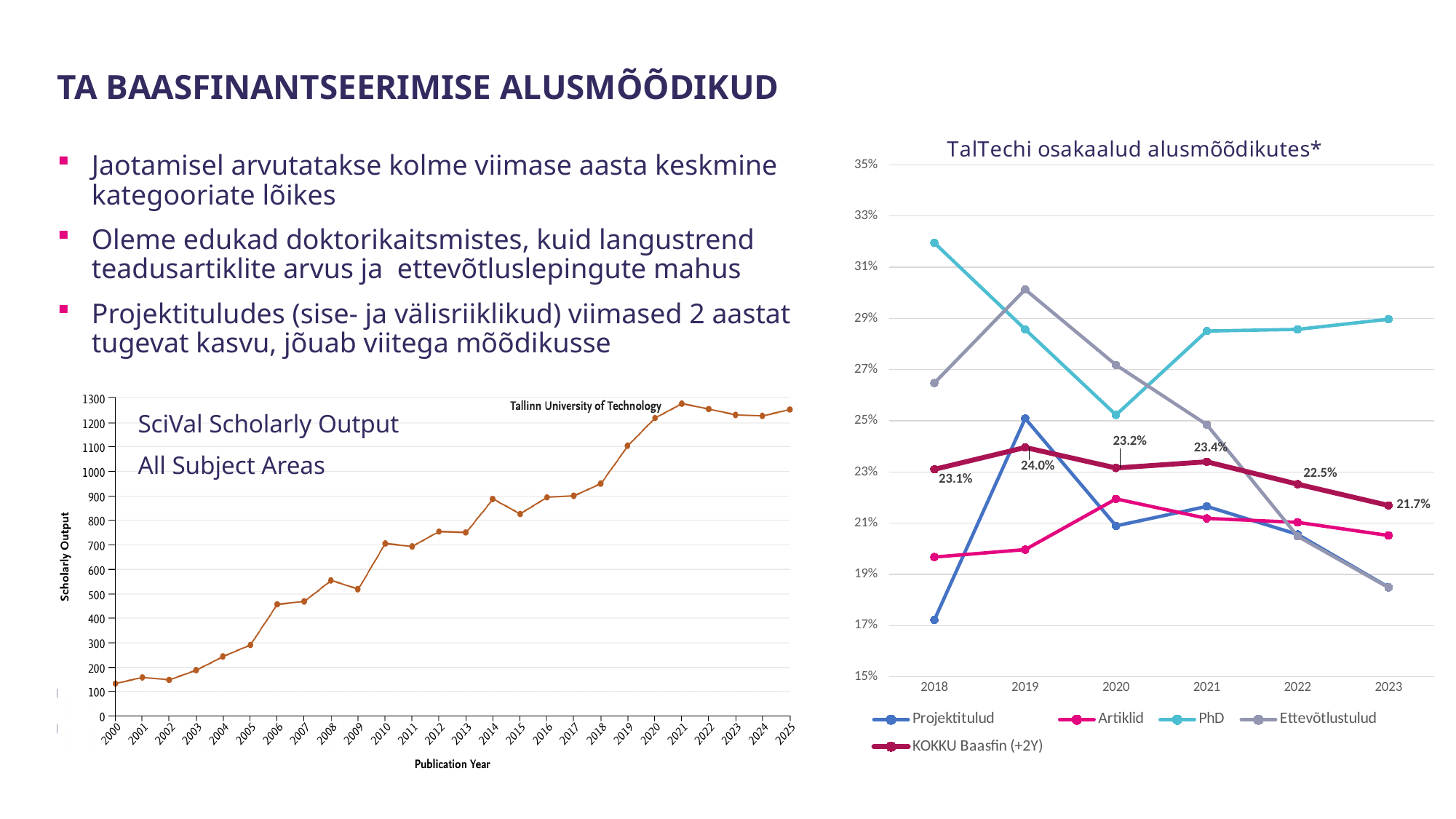
In the 'TalTechi osakaalud alusmõõdikutes*' chart, how many series does the legend list? 5 In the 'TalTechi osakaalud alusmõõdikutes*' chart, does the Ettevõtlustulud series rise or fall from 2019 to 2023? fall In the 'TalTechi osakaalud alusmõõdikutes*' chart, what is the difference between the KOKKU Baasfin (+2Y) values for 2019 and 2023? 2.3% In the 'TalTechi osakaalud alusmõõdikutes*' chart, what is the value of KOKKU Baasfin (+2Y) in 2019? 24.0% In the 'TalTechi osakaalud alusmõõdikutes*' chart, in which year is KOKKU Baasfin (+2Y) lowest? 2023 In the 'TalTechi osakaalud alusmõõdikutes*' chart, what is the value of KOKKU Baasfin (+2Y) in 2023? 21.7% In the 'SciVal Scholarly Output All Subject Areas' chart, is the value for 2021 greater or less than 1200? greater What kind of chart is the 'SciVal Scholarly Output All Subject Areas' chart? line chart In the 'TalTechi osakaalud alusmõõdikutes*' chart, which series is higher in 2023: PhD or Ettevõtlustulud? PhD In the 'TalTechi osakaalud alusmõõdikutes*' chart, is the PhD value for 2018 greater or less than 31%? greater In the 'SciVal Scholarly Output All Subject Areas' chart, what is the label of the x axis? Publication Year In the 'TalTechi osakaalud alusmõõdikutes*' chart, in which year is KOKKU Baasfin (+2Y) highest? 2019